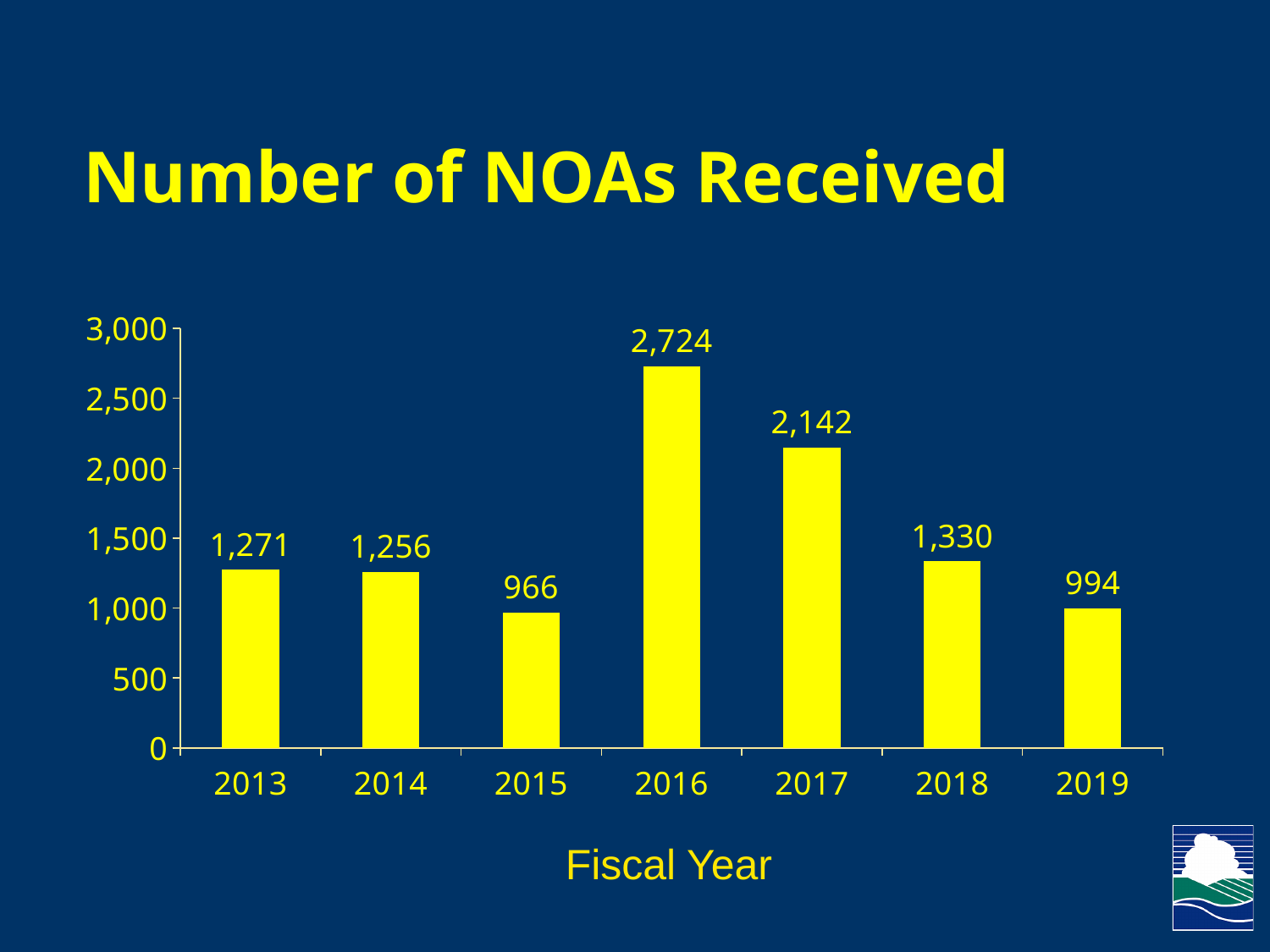
How many fiscal years are shown on the chart? 7 What is the value shown for fiscal year 2015? 966 Is the value for fiscal year 2018 greater or less than 1,500? less What is the title of the chart? Number of NOAs Received Which fiscal year had the lowest number of NOAs received? 2015 How many NOAs were received in fiscal year 2019? 994 How many more NOAs were received in 2018 than in 2019? 336 What kind of chart is shown on the slide? bar chart Which fiscal year had the highest number of NOAs received? 2016 Which fiscal year had more NOAs received, 2017 or 2018? 2017 What is the difference between the number of NOAs received in 2016 and in 2017? 582 How many NOAs were received in fiscal year 2016? 2,724